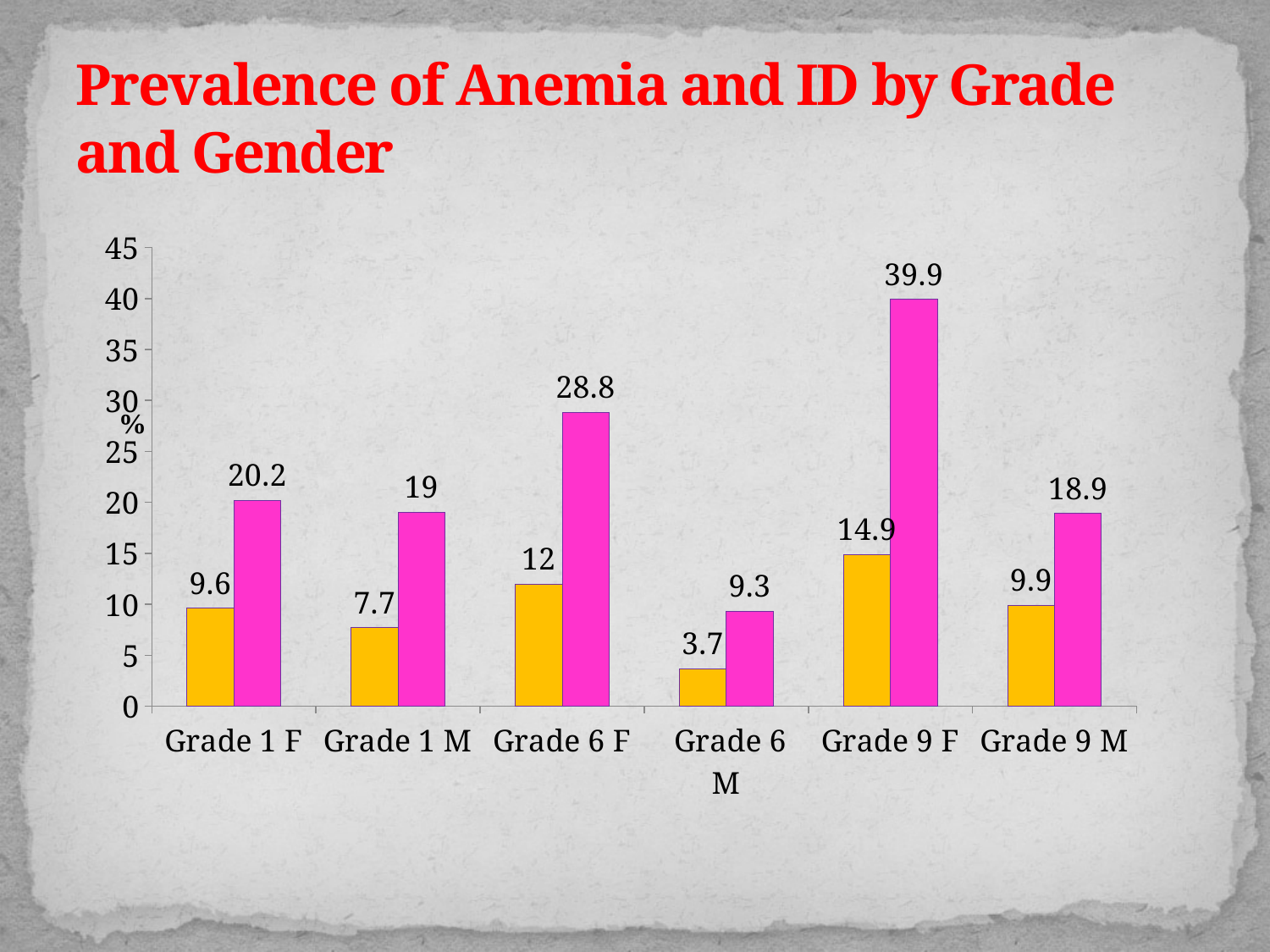
What is the difference between the pink and orange bars for Grade 6 F? 16.8 What kind of chart is shown on the slide? Bar chart How many categories are shown on the x axis? 6 What is the difference between the pink bar values for Grade 9 F and Grade 9 M? 21 Which is larger, the orange bar for Grade 9 F or the orange bar for Grade 6 F? Grade 9 F Is the pink bar for Grade 6 F greater or less than 25? greater What is the value of the orange bar for Grade 1 M? 7.7 What is the title of the slide? Prevalence of Anemia and ID by Grade and Gender What is the value of the orange bar for Grade 6 M? 3.7 What is the value of the pink bar for Grade 9 F? 39.9 Which category has the highest pink bar? Grade 9 F Which category has the lowest orange bar? Grade 6 M